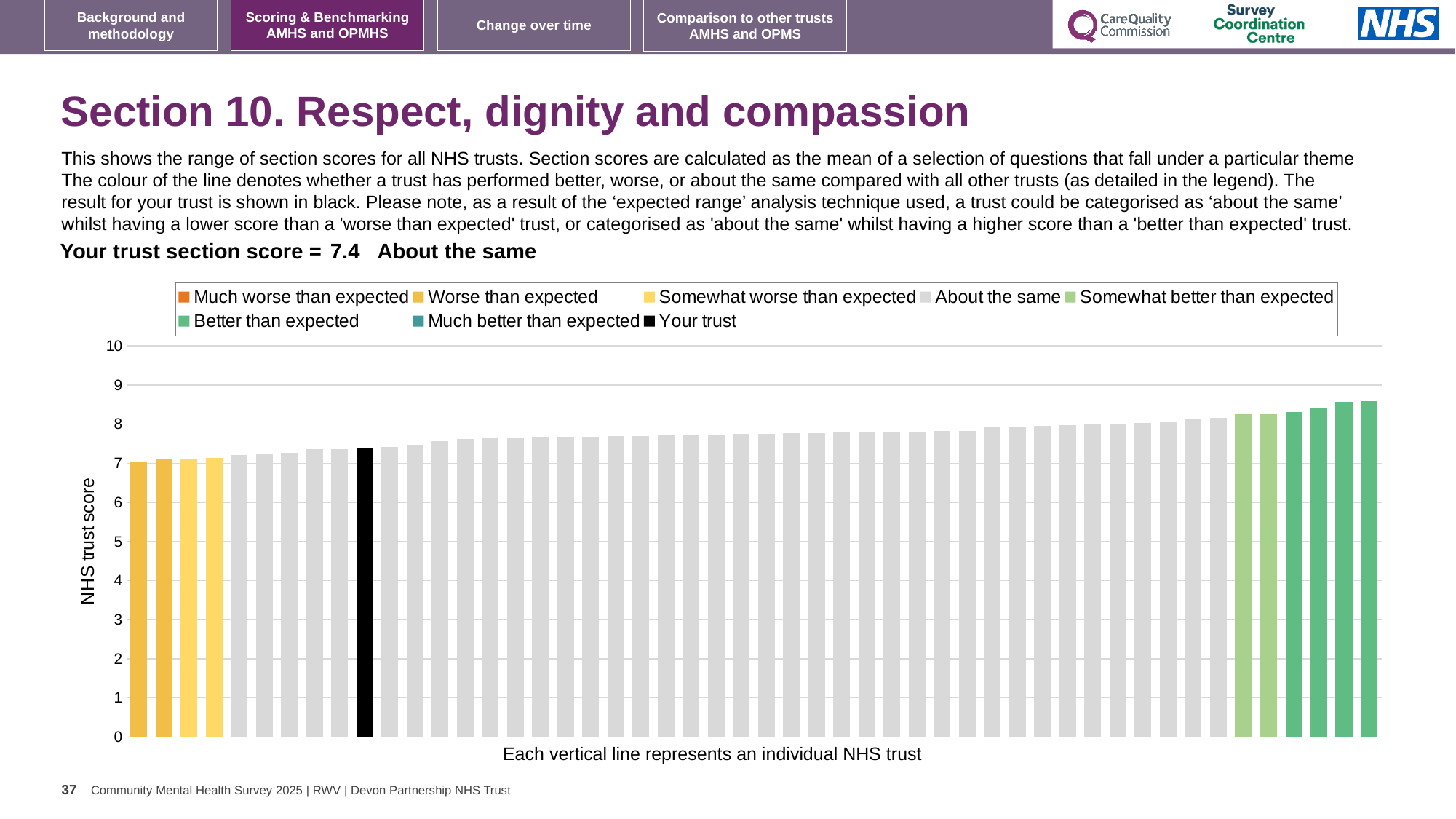
Is the value for your trust (the black bar) greater or less than 8? less What is the section score for your trust shown on the slide? 7.4 What colour does the legend use for 'Your trust'? black Is the value of the tallest bar greater or less than 8? greater What kind of chart is shown on the slide? bar chart Which is larger, the value of the black bar for your trust or the value of the rightmost bar? the rightmost bar Is the value for your trust (the black bar) greater or less than 7? greater What is the label on the vertical axis of the chart? NHS trust score Do the bar values rise or fall from left to right along the x axis? rise Which category is your trust placed in according to the slide? About the same How many entries does the chart legend list? 8